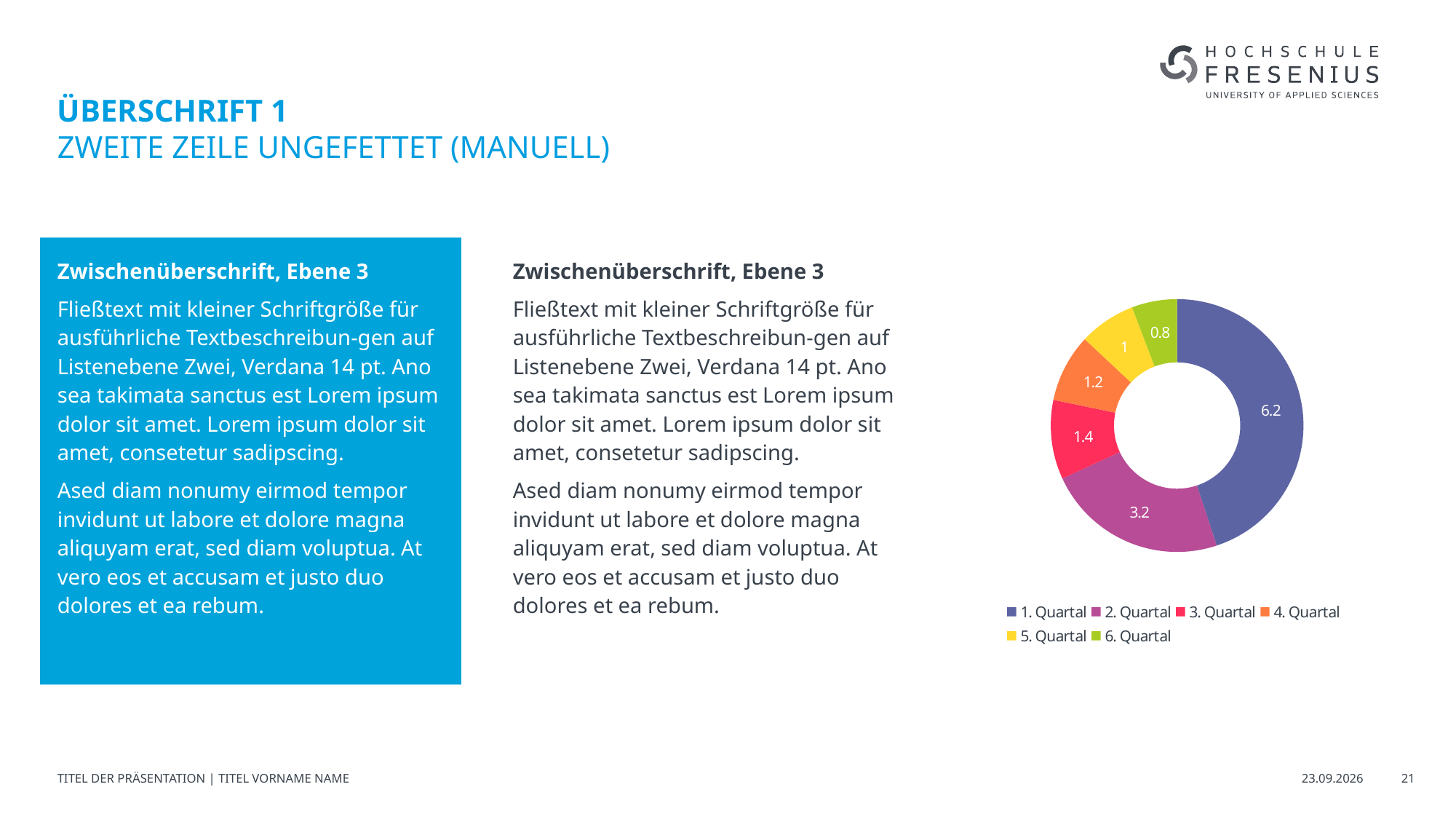
Which category has the largest slice in the chart? 1. Quartal What is the value for 4. Quartal in the chart? 1.2 What is the value for 6. Quartal in the chart? 0.8 What is the difference between the values for 1. Quartal and 2. Quartal? 3 Which category has the smallest slice in the chart? 6. Quartal What is the value for 3. Quartal in the chart? 1.4 How many categories does the chart show? 6 What is the value for 2. Quartal in the chart? 3.2 What kind of chart is shown on the slide? doughnut chart What is the value for 1. Quartal in the chart? 6.2 What is the difference between the values for 3. Quartal and 5. Quartal? 0.4 Which is larger, the value for 2. Quartal or the value for 4. Quartal? 2. Quartal